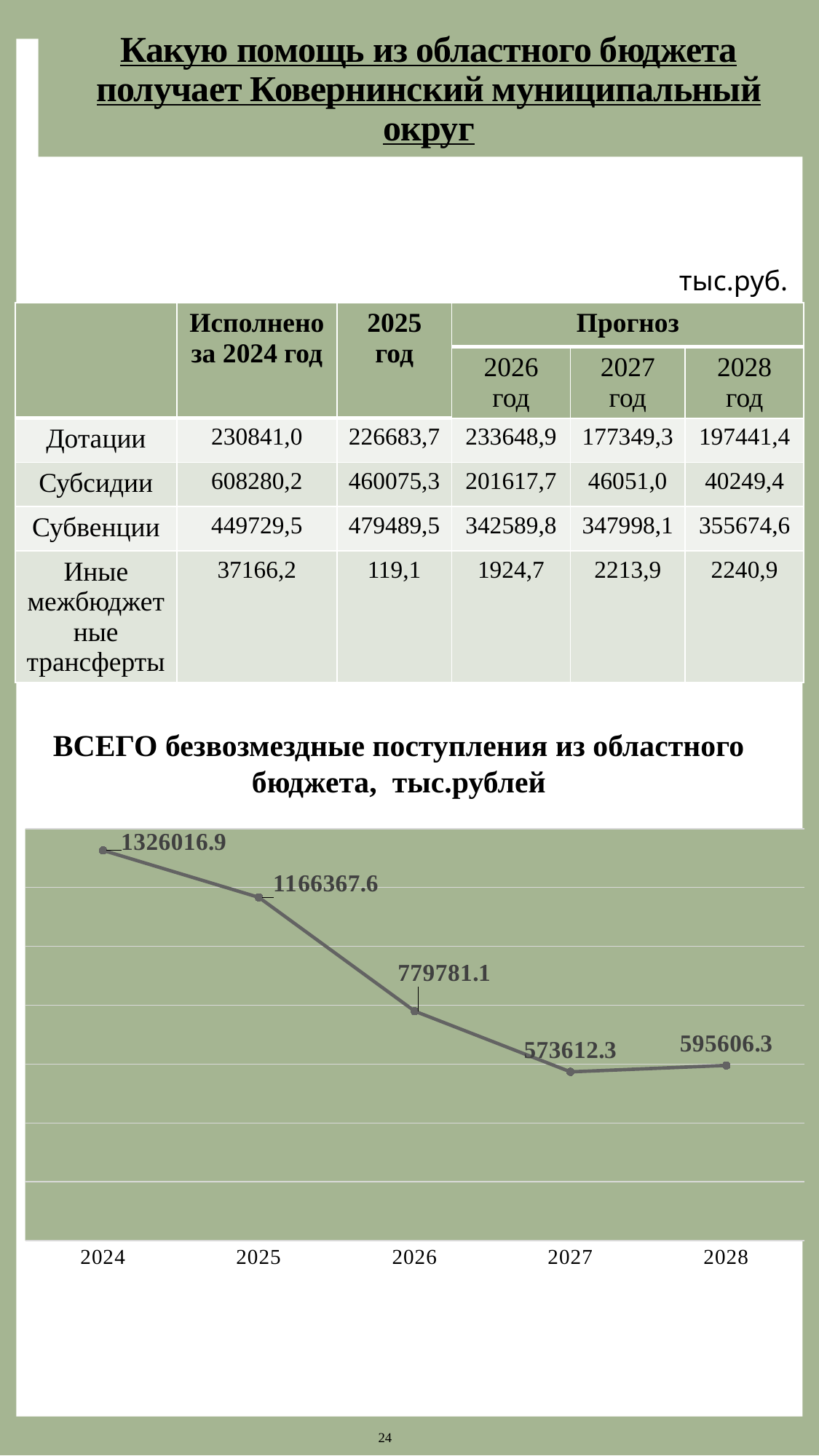
How many years are plotted on the x axis of the line chart? 5 In the line chart, which year has the lowest value? 2027 In the line chart, what is the value for 2028? 595606.3 In the line chart, what is the value for 2024? 1326016.9 In the line chart, what is the difference between the values for 2024 and 2025? 159649.3 What is the title of the line chart on the slide? ВСЕГО безвозмездные поступления из областного бюджета, тыс.рублей In the line chart, do the values generally rise or fall from 2024 to 2027? fall In the line chart, which is larger: the value for 2025 or the value for 2026? 2025 What type of chart is shown under the heading "ВСЕГО безвозмездные поступления из областного бюджета, тыс.рублей"? line chart In the line chart, what is the value for 2026? 779781.1 In the line chart, which year has the highest value? 2024 In the line chart, what is the difference between the values for 2028 and 2027? 21994.0